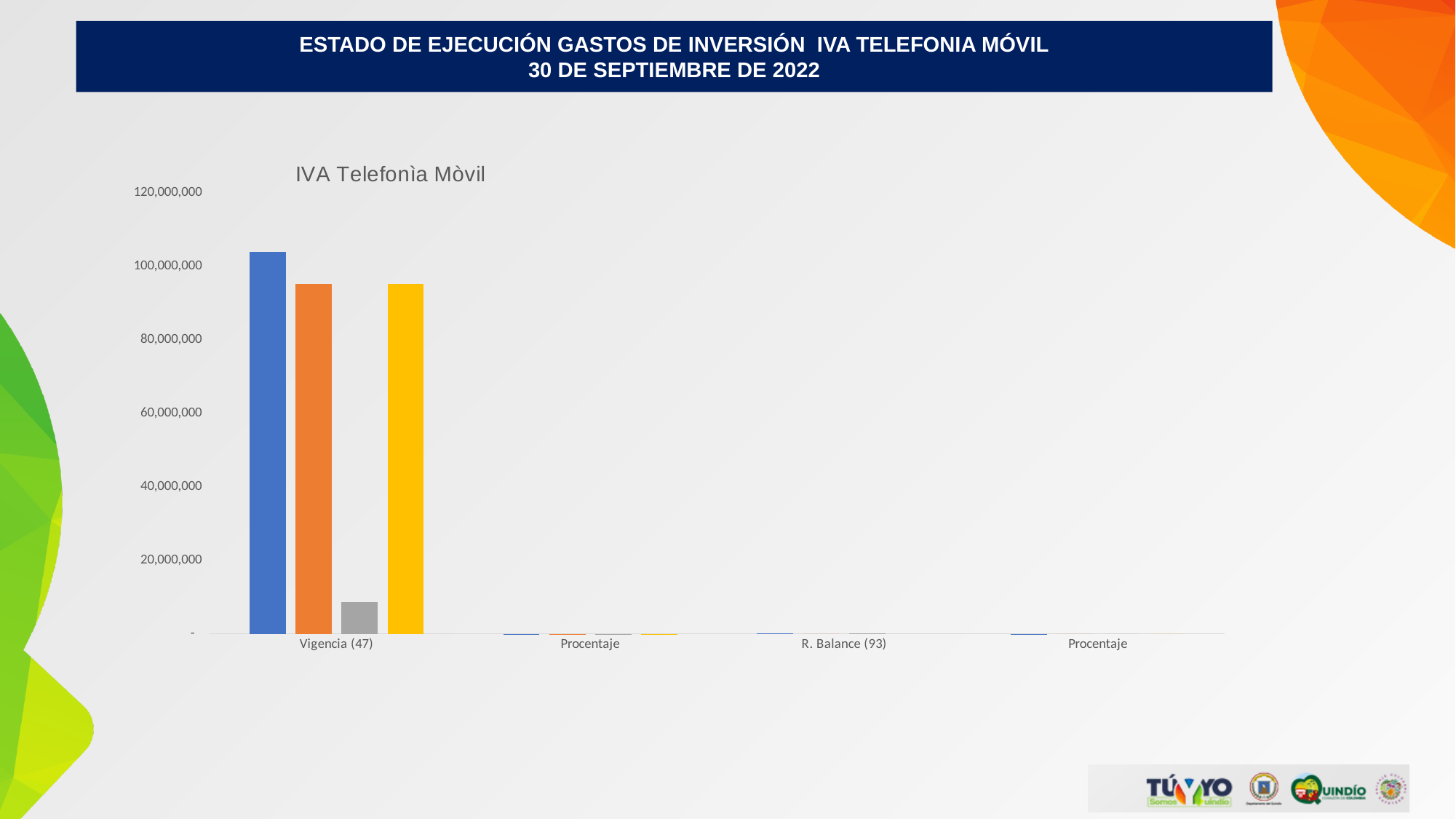
In the Vigencia (47) category, which is larger, the blue bar or the orange bar? blue How many categories are shown along the x axis of the chart? 4 Is the value of the orange bar in the Vigencia (47) category greater or less than 100,000,000? less Which coloured bar is the shortest in the Vigencia (47) category? gray Is the value of the gray bar in the Vigencia (47) category greater or less than 20,000,000? less Is the value of the yellow bar in the Vigencia (47) category greater or less than 80,000,000? greater Which coloured bar is the tallest in the Vigencia (47) category? blue What is the highest value shown on the vertical axis of the chart? 120,000,000 What is the title of the chart? IVA Telefonìa Mòvil What kind of chart is shown on the slide? bar chart